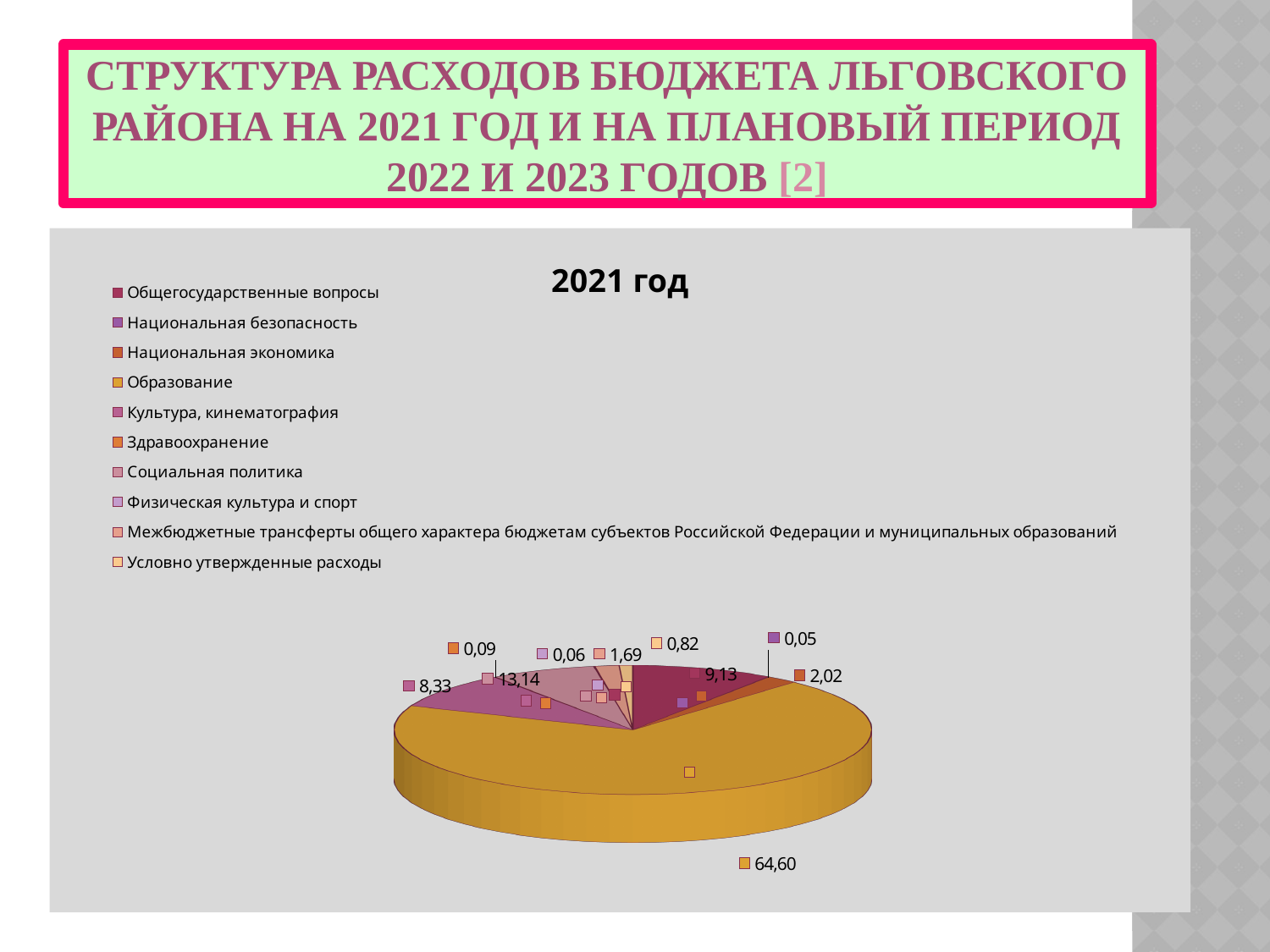
What is the value shown for Культура, кинематография? 8,33 Which category has the largest slice of the pie chart? Образование What type of chart is shown on the slide? pie chart How many categories does the legend of the pie chart list? 10 What is the value shown for Социальная политика? 13,14 What is the difference between the values for Образование (64,60) and Социальная политика (13,14)? 51,46 What is the value shown for Общегосударственные вопросы? 9,13 Which category has the smallest value in the pie chart? Национальная безопасность What is the title of the chart? 2021 год What is the value shown for the largest slice of the pie chart? 64,60 What is the value shown for Национальная экономика? 2,02 Which is larger: the value for Общегосударственные вопросы or the value for Культура, кинематография? Общегосударственные вопросы